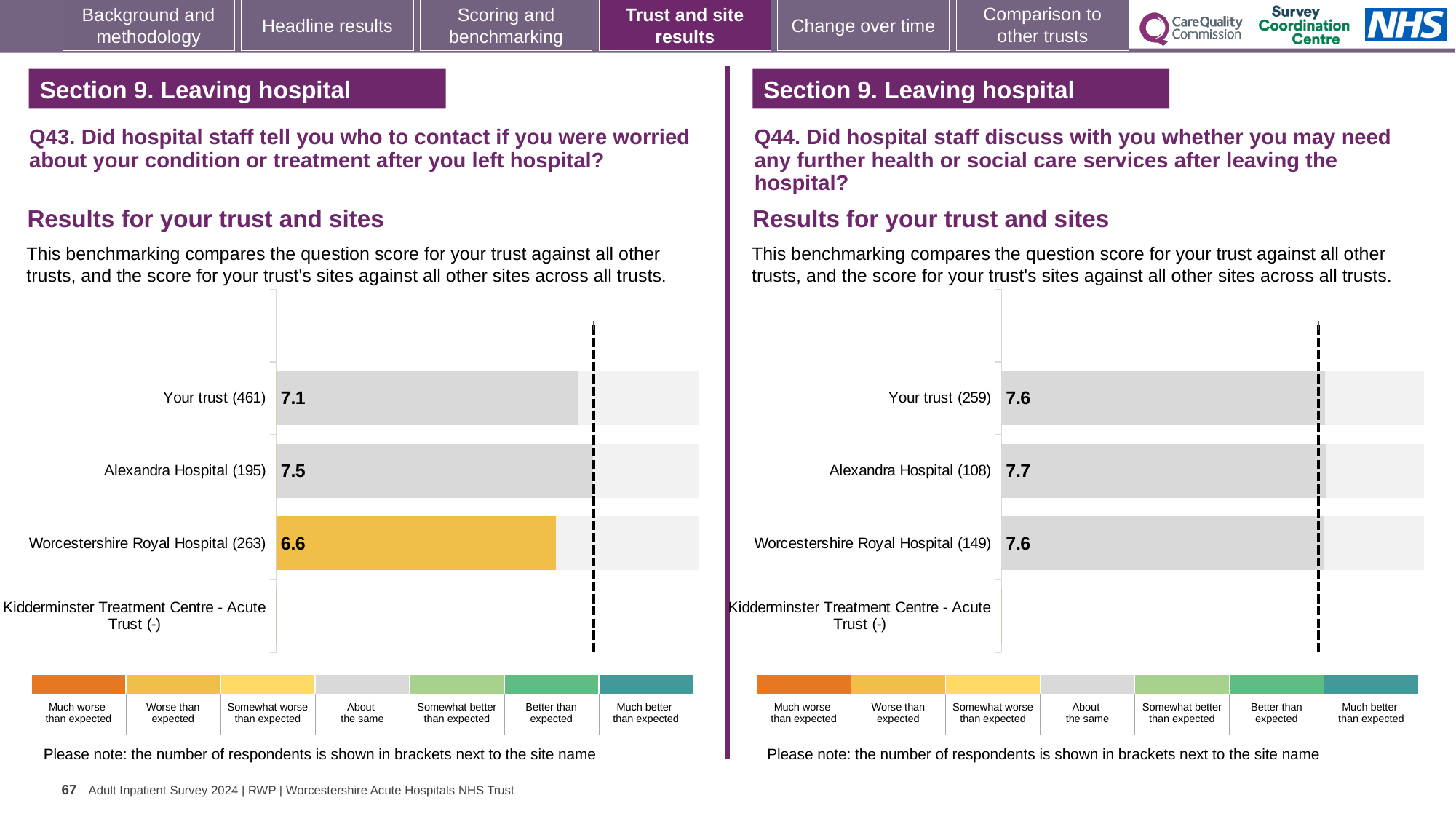
In the Q44 chart on the right, what is the score for Alexandra Hospital? 7.7 In the Q44 chart on the right, how many respondents are shown in brackets for Worcestershire Royal Hospital? 149 In the Q43 chart on the left, how many respondents are shown in brackets for Your trust? 461 In the Q44 chart on the right, what is the difference between the scores for Alexandra Hospital and Your trust? 0.1 In the Q43 chart on the left, what is the score for Your trust? 7.1 What kind of chart is used in the Q43 chart on the left? Bar chart In the Q43 chart on the left, what is the difference between the scores for Alexandra Hospital and Worcestershire Royal Hospital? 0.9 In the Q43 chart on the left, which site has the highest score? Alexandra Hospital In the Q43 chart on the left, what is the score for Worcestershire Royal Hospital? 6.6 In the Q44 chart on the right, what is the score for Your trust? 7.6 In the Q43 chart on the left, which site has the lowest score? Worcestershire Royal Hospital In the Q43 chart on the left, which benchmark category does the colour of the Worcestershire Royal Hospital bar correspond to in the key? Worse than expected